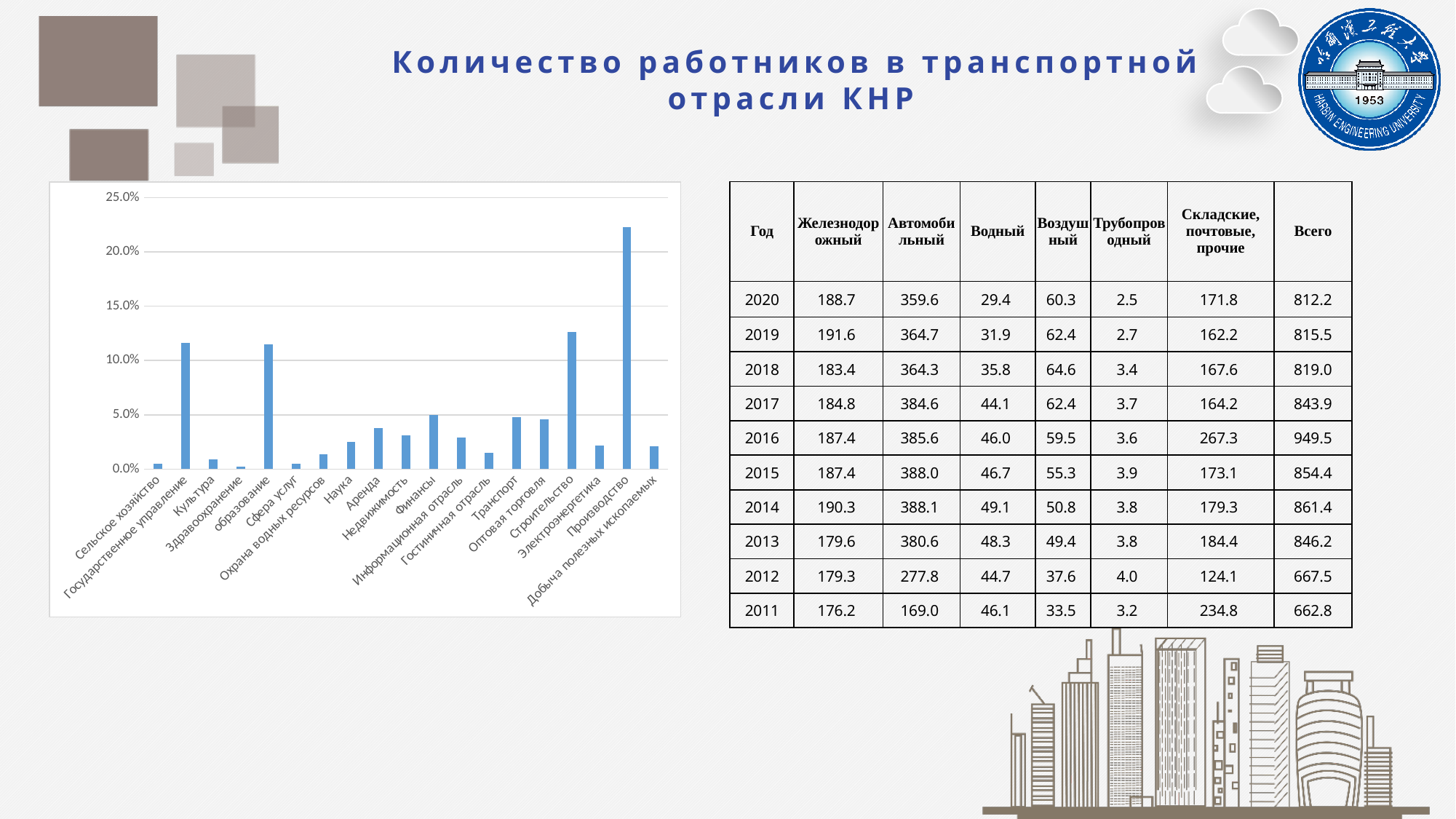
What kind of chart is shown on the left of the slide? bar chart Which category has the highest value in the bar chart? Производство Which is larger in the bar chart, Финансы or Информационная отрасль? Финансы Which is larger in the bar chart, Аренда or Наука? Аренда Is the value for Наука greater or less than 5%? less Is the value for Здравоохранение greater or less than 5%? less Is the value for Производство greater or less than 20%? greater How many categories are plotted in the bar chart? 19 Which is larger in the bar chart, Производство or Строительство? Производство What is the highest value shown on the vertical axis of the bar chart? 25.0%